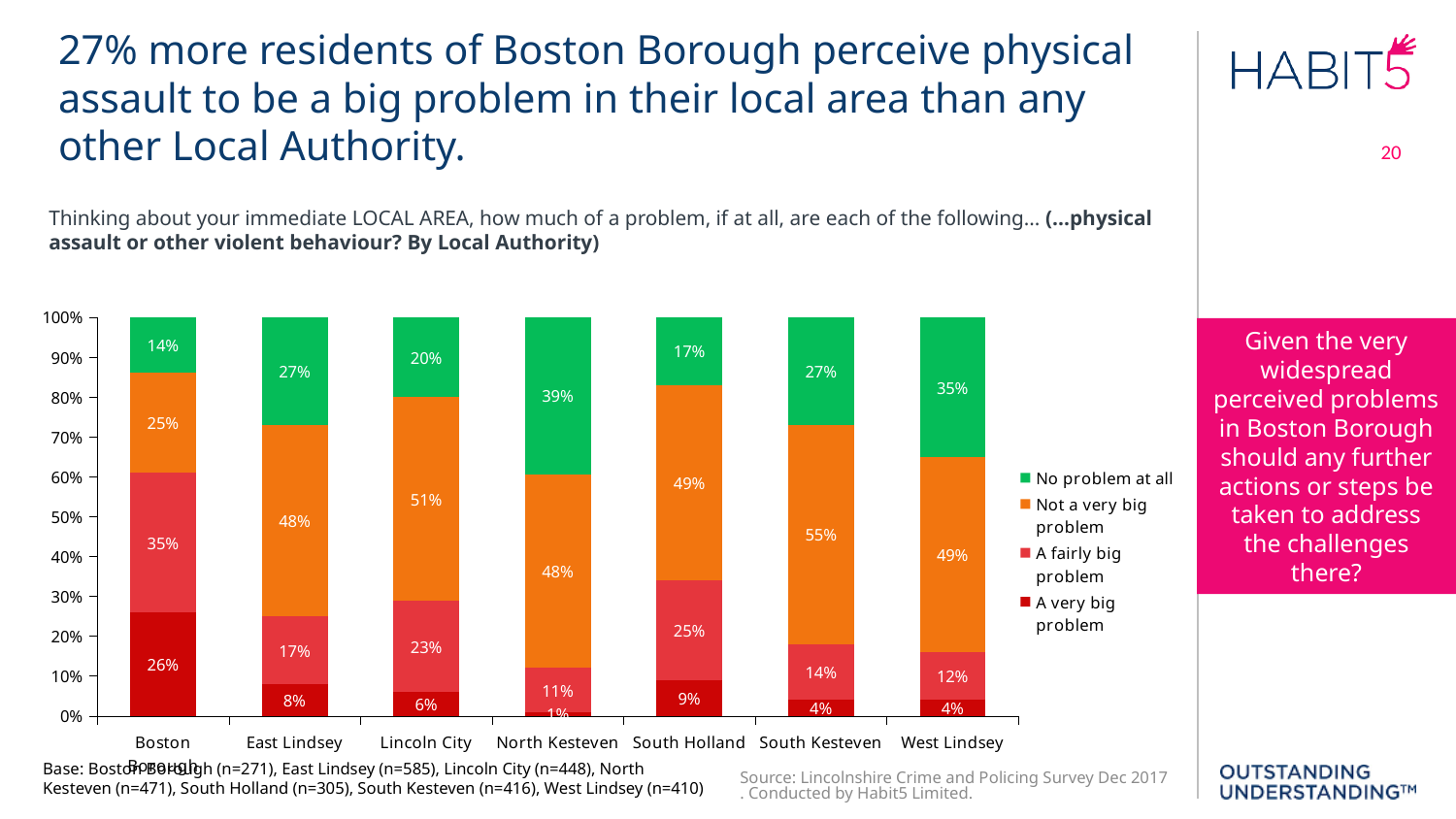
Which colour represents 'No problem at all' in the chart legend? Green What is the difference between the 'A fairly big problem' share in Boston Borough and in East Lindsey? 18 percentage points How many local authorities are shown on the x axis of the chart? 7 What is the combined share of 'A very big problem' and 'A fairly big problem' responses for Boston Borough? 61% Which local authority has the highest share of residents saying physical assault is a very big problem? Boston Borough What percentage of North Kesteven residents say there is no problem at all? 39% How many series does the chart legend list? 4 What percentage of Boston Borough residents say physical assault is a very big problem? 26% Which local authority has the lowest share of residents saying physical assault is a very big problem? North Kesteven What percentage of South Kesteven residents say physical assault is not a very big problem? 55% What type of chart is shown on the slide? Stacked bar chart Which has a larger 'No problem at all' share, West Lindsey or Lincoln City? West Lindsey